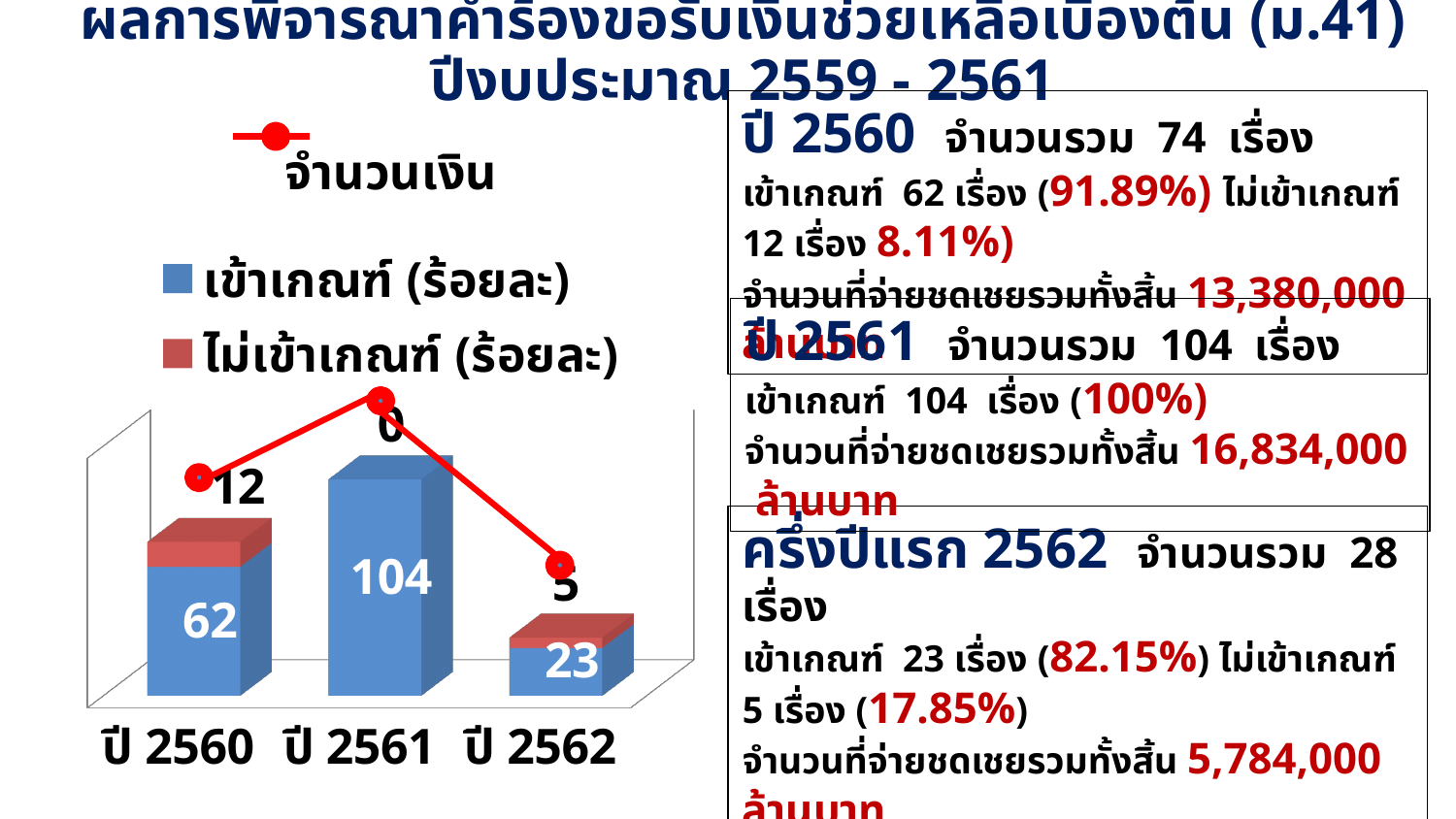
What is the value of ไม่เข้าเกณฑ์ (ร้อยละ) for ปี 2561? 0 What is the difference between the เข้าเกณฑ์ (ร้อยละ) values for ปี 2561 and ปี 2560? 42 What is the total of the stacked bar for ปี 2562? 28 Which year has the lowest value for เข้าเกณฑ์ (ร้อยละ)? ปี 2562 What is the value of เข้าเกณฑ์ (ร้อยละ) for ปี 2561? 104 What is the total of the stacked bar for ปี 2560? 74 What is the value of ไม่เข้าเกณฑ์ (ร้อยละ) for ปี 2560? 12 What is the value of เข้าเกณฑ์ (ร้อยละ) for ปี 2562? 23 Which is larger: ไม่เข้าเกณฑ์ (ร้อยละ) for ปี 2560 or for ปี 2562? ปี 2560 How many series does the chart legend list? 3 Which year has the highest value for เข้าเกณฑ์ (ร้อยละ)? ปี 2561 How many year categories are shown on the x axis of the chart? 3